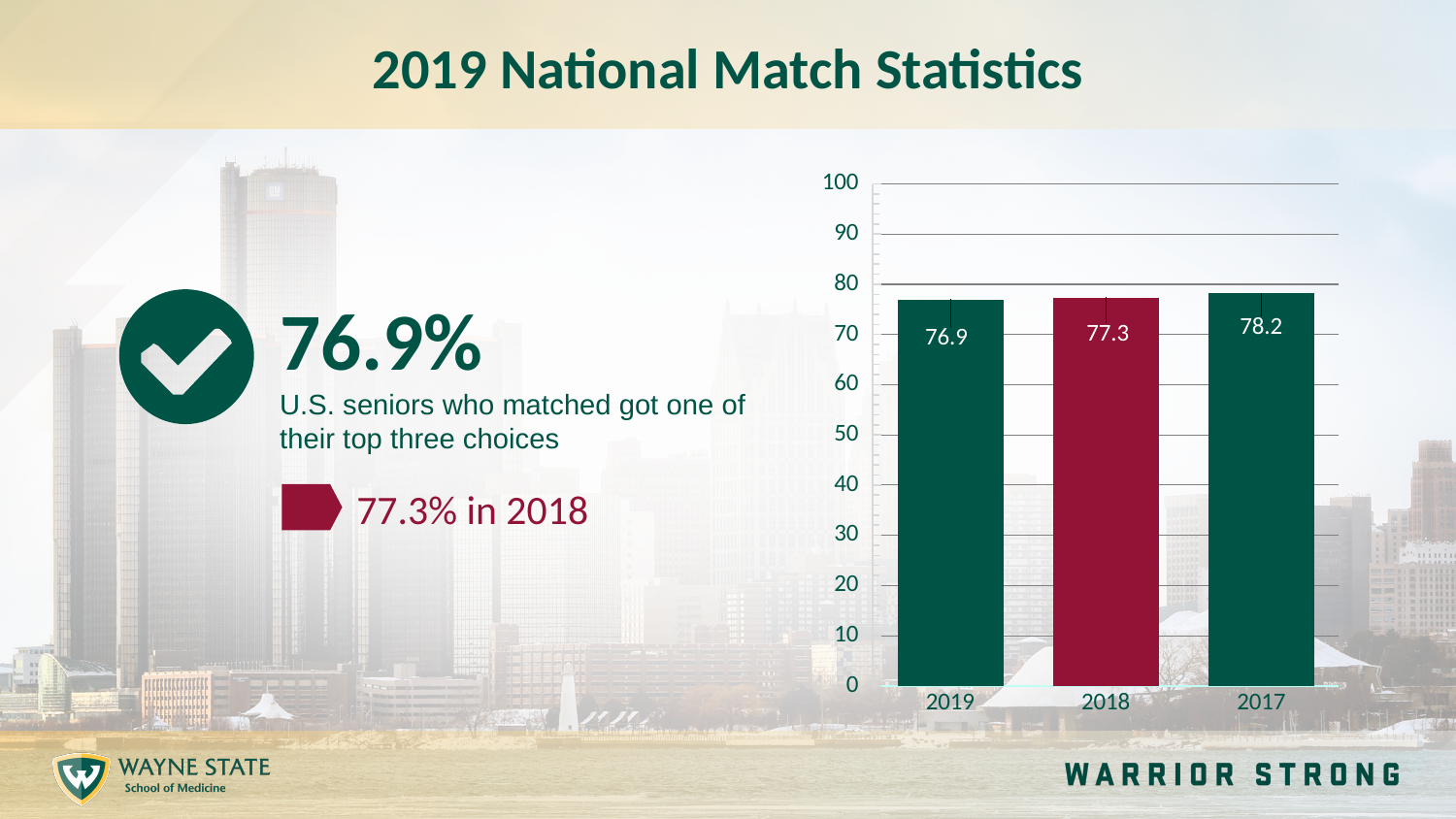
What kind of chart is shown on the slide? bar chart What is the difference between the values for 2017 and 2019? 1.3 How many years are shown in the chart? 3 What value is shown for 2017? 78.2 What value is shown for 2018? 77.3 Which year has the highest value in the chart? 2017 Which is larger, the value for 2018 or the value for 2019? 2018 What value is shown for 2019? 76.9 Is the value for 2019 greater or less than 80? less Which bar is coloured differently (red) from the others? 2018 Which year has the lowest value in the chart? 2019 What is the difference between the values for 2018 and 2019? 0.4